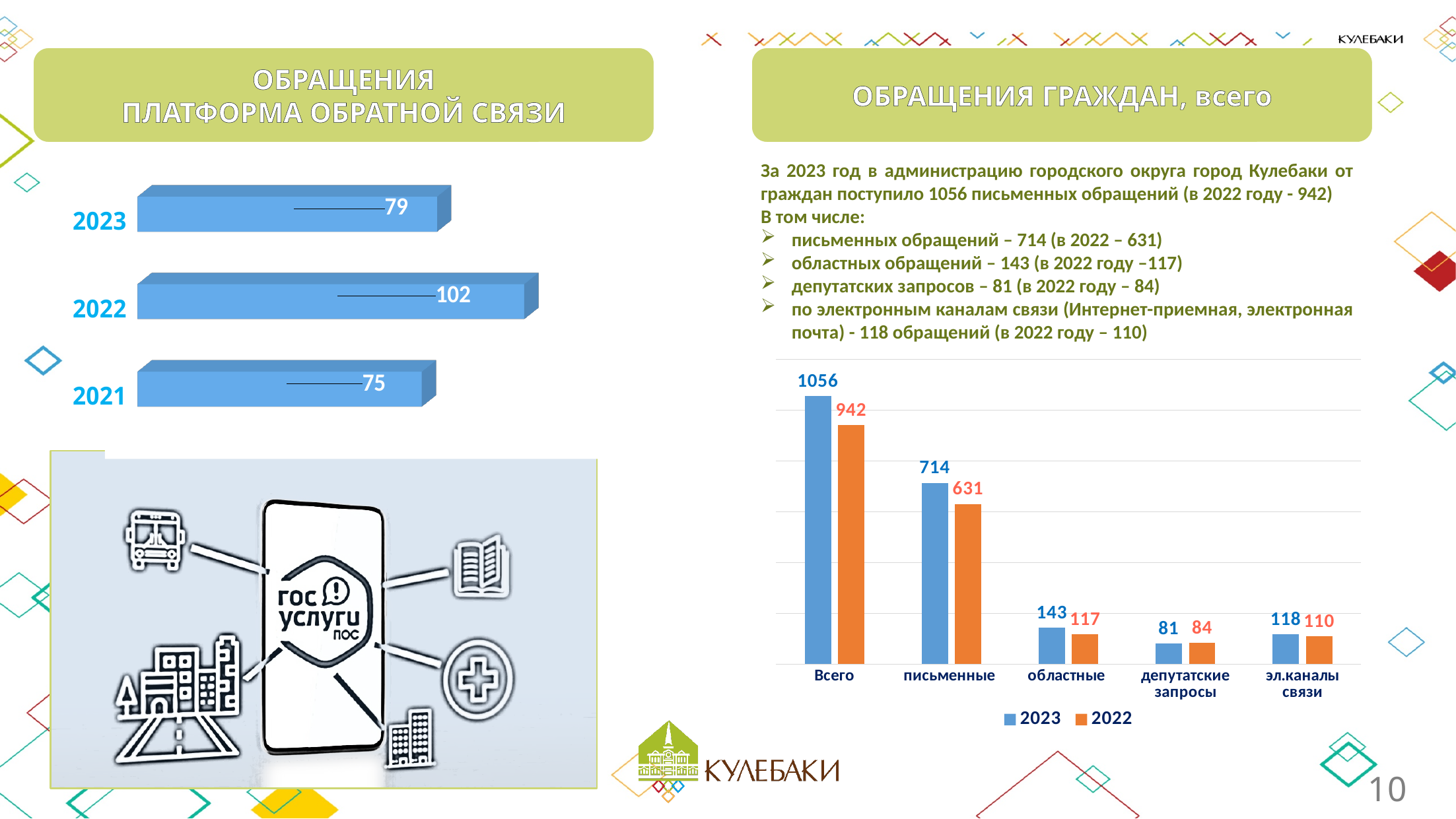
How many series does the legend of the right chart (ОБРАЩЕНИЯ ГРАЖДАН, всего) list? 2 In the right chart (ОБРАЩЕНИЯ ГРАЖДАН, всего), what is the difference between the 2023 and 2022 values for Всего? 114 In the right chart (ОБРАЩЕНИЯ ГРАЖДАН, всего), for депутатские запросы, which year has the larger value, 2023 or 2022? 2022 In the left chart (ОБРАЩЕНИЯ ПЛАТФОРМА ОБРАТНОЙ СВЯЗИ), how many years are shown? 3 In the left chart (ОБРАЩЕНИЯ ПЛАТФОРМА ОБРАТНОЙ СВЯЗИ), what is the difference between the 2022 and 2023 values? 23 What kind of chart is the left chart (ОБРАЩЕНИЯ ПЛАТФОРМА ОБРАТНОЙ СВЯЗИ)? Bar chart In the right chart (ОБРАЩЕНИЯ ГРАЖДАН, всего), what is the 2022 value for областные? 117 In the right chart (ОБРАЩЕНИЯ ГРАЖДАН, всего), which category has the lowest 2023 value? депутатские запросы In the right chart (ОБРАЩЕНИЯ ГРАЖДАН, всего), which colour represents 2022? Orange In the left chart (ОБРАЩЕНИЯ ПЛАТФОРМА ОБРАТНОЙ СВЯЗИ), what is the value for 2022? 102 In the right chart (ОБРАЩЕНИЯ ГРАЖДАН, всего), what is the 2023 value for письменные? 714 In the left chart (ОБРАЩЕНИЯ ПЛАТФОРМА ОБРАТНОЙ СВЯЗИ), which year has the lowest value? 2021